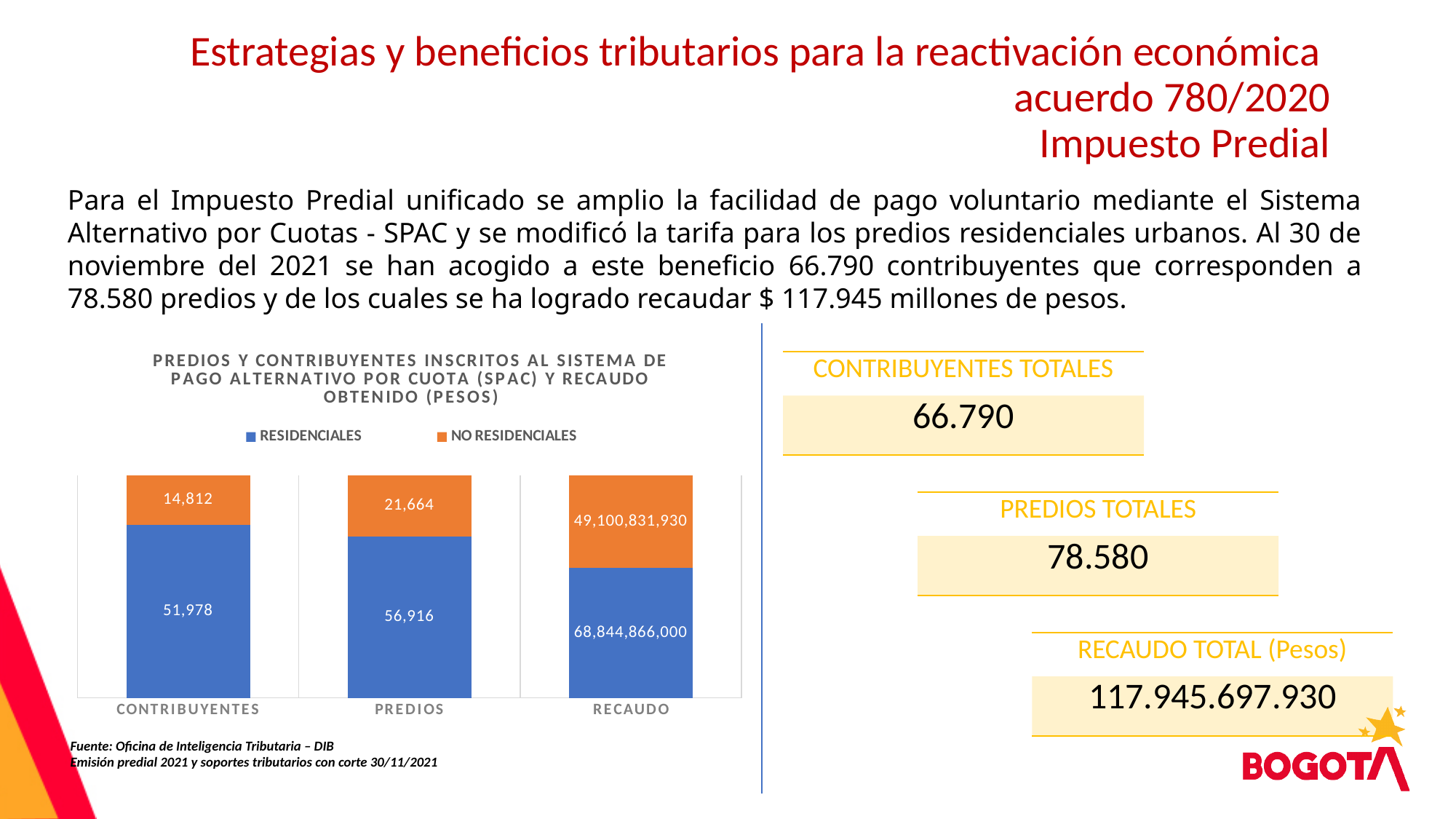
What is the NO RESIDENCIALES value for RECAUDO? 49,100,831,930 Which series is shown in orange in the chart? NO RESIDENCIALES What is the total of the stacked bar for PREDIOS? 78,580 How many categories are shown on the x axis of the chart? 3 What is the RESIDENCIALES value for CONTRIBUYENTES? 51,978 What is the RESIDENCIALES value for PREDIOS? 56,916 What is the difference between the RESIDENCIALES and NO RESIDENCIALES values for PREDIOS? 35,252 What is the NO RESIDENCIALES value for CONTRIBUYENTES? 14,812 What is the RESIDENCIALES value for RECAUDO? 68,844,866,000 What type of chart is shown on the slide? Stacked bar chart What is the total of the stacked bar for CONTRIBUYENTES? 66,790 How many series does the chart legend list? 2